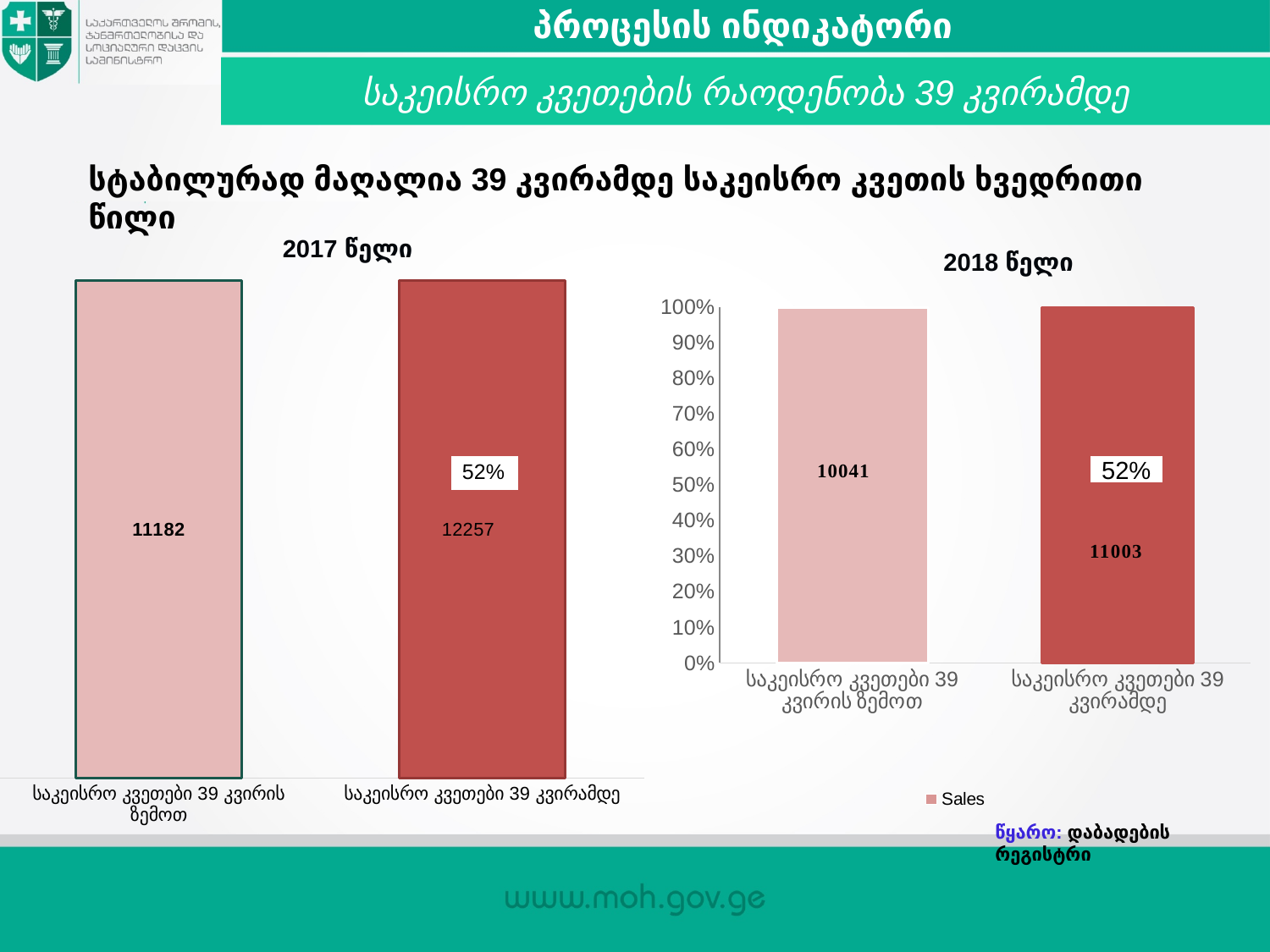
What type of chart is the 2017 წელი chart? Bar chart In the 2017 წელი chart, what is the difference between the labelled values 12257 and 11182? 1075 In the 2017 წელი chart, what value is labelled on the bar for საკეისრო კვეთები 39 კვირის ზემოთ? 11182 In the 2018 წელი chart, which labelled value is larger: საკეისრო კვეთები 39 კვირის ზემოთ or საკეისრო კვეთები 39 კვირამდე? საკეისრო კვეთები 39 კვირამდე In the 2017 წელი chart, what value is labelled on the bar for საკეისრო კვეთები 39 კვირამდე? 12257 In the 2018 წელი chart, what percentage is shown in the box on the საკეისრო კვეთები 39 კვირამდე bar? 52% In the 2018 წელი chart, what value is labelled on the bar for საკეისრო კვეთები 39 კვირამდე? 11003 In the 2018 წელი chart, what is the difference between the labelled values 11003 and 10041? 962 In the 2018 წელი chart, what value is labelled on the bar for საკეისრო კვეთები 39 კვირის ზემოთ? 10041 In the 2017 წელი chart, what percentage is shown in the box on the საკეისრო კვეთები 39 კვირამდე bar? 52% How many bars are plotted in the 2018 წელი chart? 2 What is the legend entry shown under the 2018 წელი chart? Sales